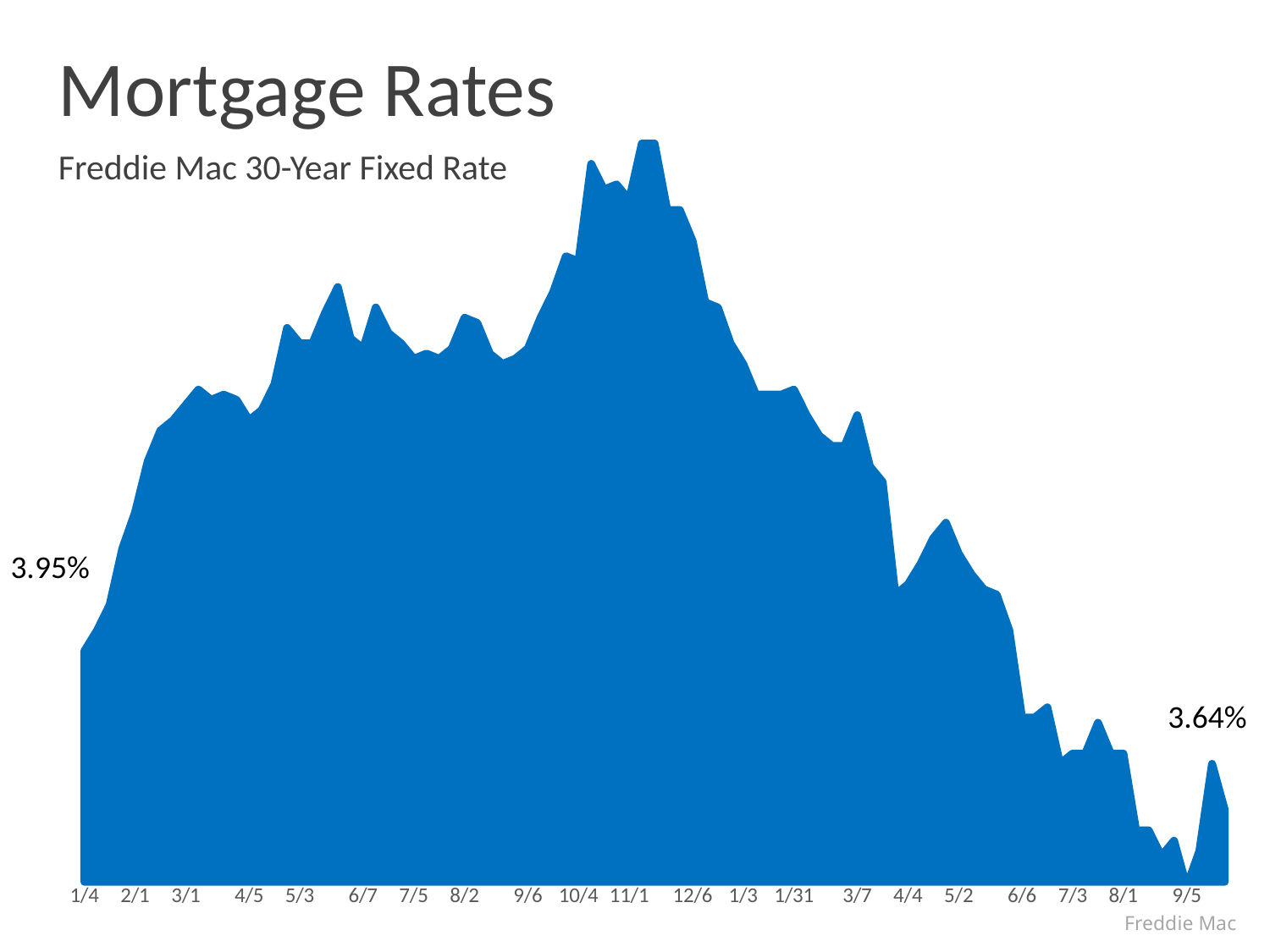
How many date labels are shown on the x axis? 21 Around which x-axis label does the series reach its highest point? 11/1 What is the value printed at the start of the series, at 1/4? 3.95% Does the series rise or fall between 1/4 and 5/3? Rise Which is larger, the starting value at 1/4 or the ending value of the series? The starting value at 1/4 (3.95%) What is the value printed at the end of the series? 3.64% What is the title of the chart? Mortgage Rates What is the difference between the starting value (3.95%) and the ending value (3.64%)? 0.31% What is the subtitle shown under the chart title? Freddie Mac 30-Year Fixed Rate Does the series rise or fall between 11/1 and 9/5? Fall What kind of chart is shown on the slide? Area chart